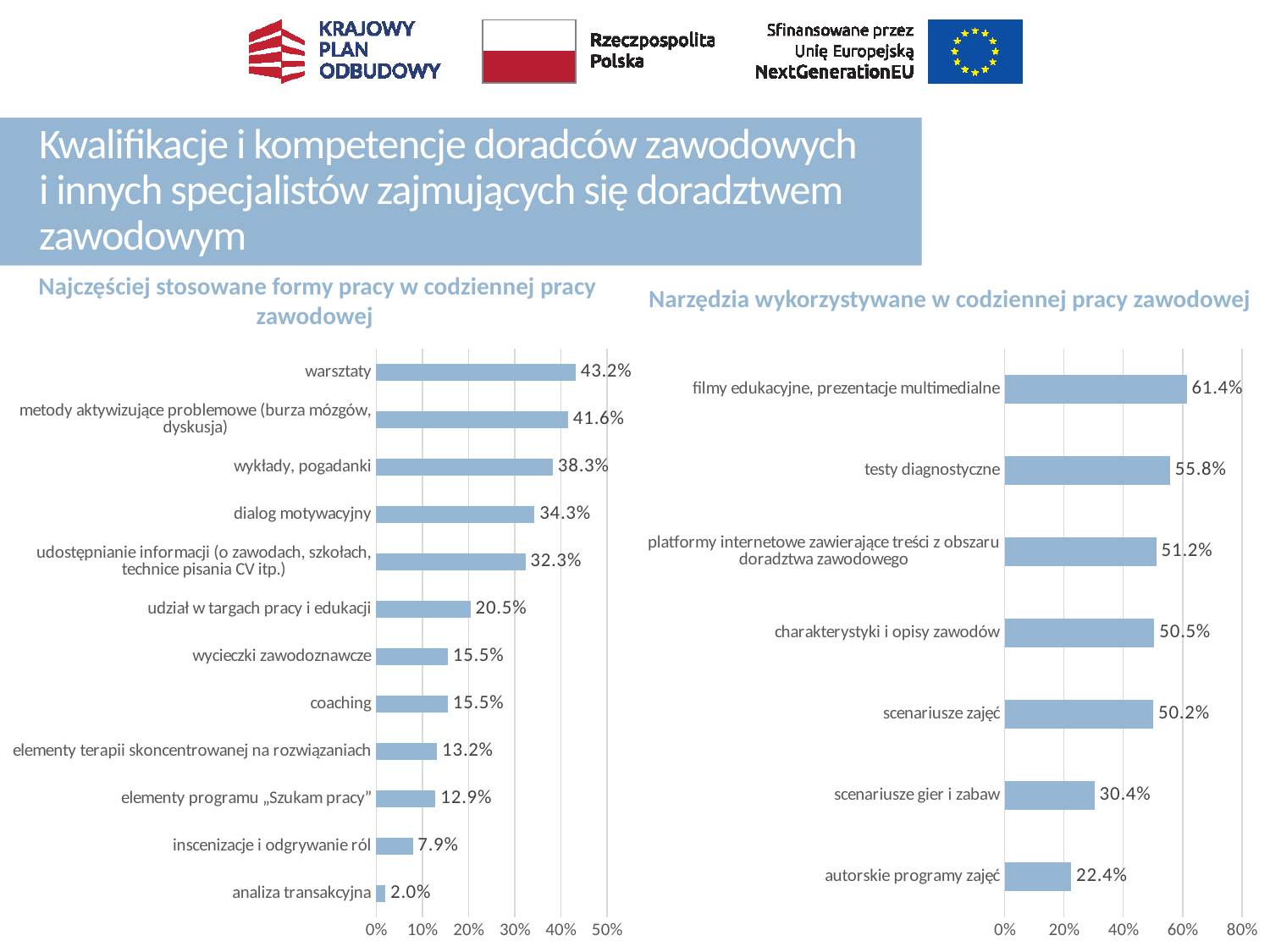
What type of chart is 'Narzędzia wykorzystywane w codziennej pracy zawodowej'? bar chart In the chart 'Narzędzia wykorzystywane w codziennej pracy zawodowej', how many categories are shown? 7 In the chart 'Narzędzia wykorzystywane w codziennej pracy zawodowej', what is the value for 'scenariusze zajęć'? 50.2% In the chart 'Najczęściej stosowane formy pracy w codziennej pracy zawodowej', which category has the lowest value? analiza transakcyjna In the chart 'Narzędzia wykorzystywane w codziennej pracy zawodowej', what is the value for 'testy diagnostyczne'? 55.8% In the chart 'Narzędzia wykorzystywane w codziennej pracy zawodowej', which category has the highest value? filmy edukacyjne, prezentacje multimedialne In the chart 'Najczęściej stosowane formy pracy w codziennej pracy zawodowej', what is the value for 'warsztaty'? 43.2% In the chart 'Najczęściej stosowane formy pracy w codziennej pracy zawodowej', what is the value for 'inscenizacje i odgrywanie ról'? 7.9% In the chart 'Najczęściej stosowane formy pracy w codziennej pracy zawodowej', how many categories are shown? 12 In the chart 'Narzędzia wykorzystywane w codziennej pracy zawodowej', what is the difference between 'scenariusze gier i zabaw' and 'autorskie programy zajęć'? 8.0% In the chart 'Najczęściej stosowane formy pracy w codziennej pracy zawodowej', which is larger: 'udział w targach pracy i edukacji' or 'coaching'? udział w targach pracy i edukacji In the chart 'Najczęściej stosowane formy pracy w codziennej pracy zawodowej', what is the difference between 'wykłady, pogadanki' and 'dialog motywacyjny'? 4.0%